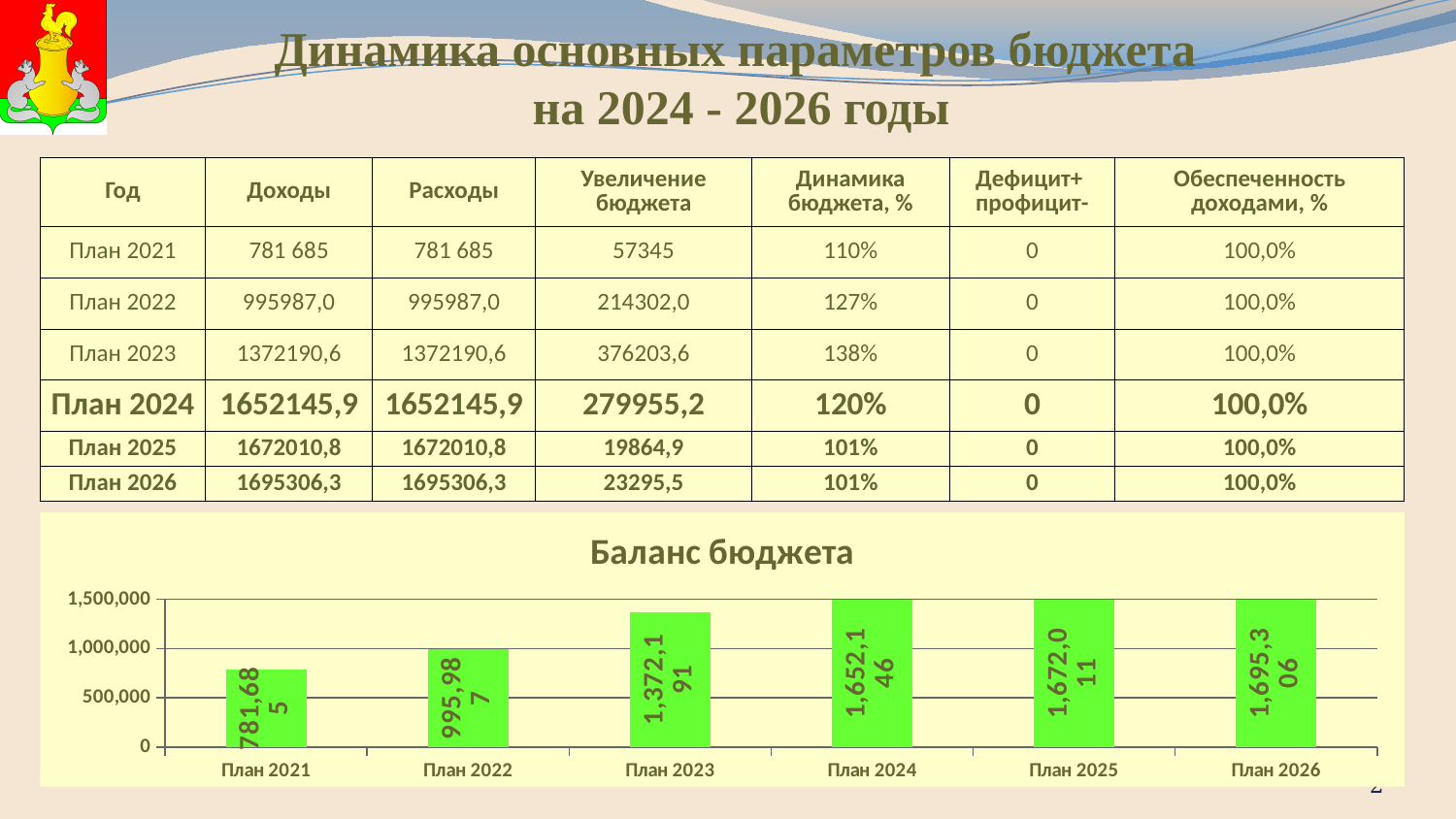
How many categories are shown in the Баланс бюджета chart? 6 Which category has the highest value in the Баланс бюджета chart? План 2026 What is the value for План 2024 in the Баланс бюджета chart? 1,652,146 Do the values in the Баланс бюджета chart rise or fall from План 2021 to План 2026? rise What is the value for План 2023 in the Баланс бюджета chart? 1,372,191 What is the value for План 2021 in the Баланс бюджета chart? 781,685 What is the value for План 2026 in the Баланс бюджета chart? 1,695,306 Is the value for План 2022 in the Баланс бюджета chart greater or less than 1,000,000? less Which category has the lowest value in the Баланс бюджета chart? План 2021 What is the difference between the values for План 2022 and План 2021 in the Баланс бюджета chart? 214,302 What kind of chart is the Баланс бюджета chart? bar chart Which is larger in the Баланс бюджета chart, the value for План 2023 or the value for План 2022? План 2023